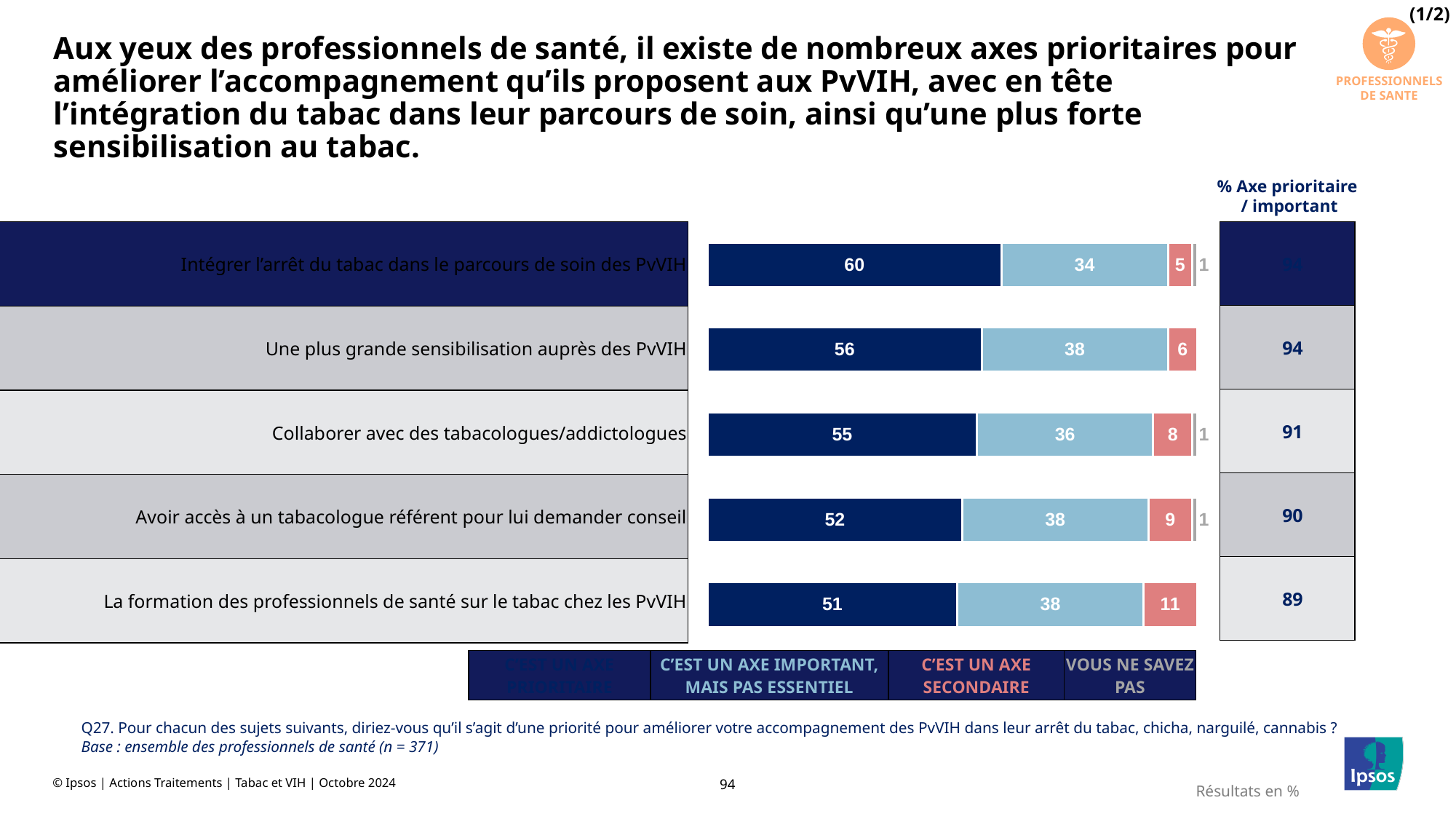
What is the value of the dark blue (first) segment for "Intégrer l'arrêt du tabac dans le parcours de soin des PvVIH"? 60 What is the total of the stacked bar for "Une plus grande sensibilisation auprès des PvVIH"? 100 What is the "% Axe prioritaire / important" value shown for "Collaborer avec des tabacologues/addictologues"? 91 Which item has the lowest value in the dark blue (first) segment? La formation des professionnels de santé sur le tabac chez les PvVIH What is the value of the "C'est un axe important, mais pas essentiel" segment for "Une plus grande sensibilisation auprès des PvVIH"? 38 How many items (categories) are plotted in the chart? 5 Which has a larger "C'est un axe secondaire" value: "Collaborer avec des tabacologues/addictologues" or "Avoir accès à un tabacologue référent pour lui demander conseil"? Avoir accès à un tabacologue référent pour lui demander conseil What kind of chart is shown on the slide? Stacked bar chart What is the difference between the dark blue segment values for "Intégrer l'arrêt du tabac dans le parcours de soin des PvVIH" and "Avoir accès à un tabacologue référent pour lui demander conseil"? 8 Which item has the highest value in the dark blue (first) segment? Intégrer l'arrêt du tabac dans le parcours de soin des PvVIH What is the value of the "C'est un axe secondaire" segment for "La formation des professionnels de santé sur le tabac chez les PvVIH"? 11 How many series does the legend below the chart list? 4